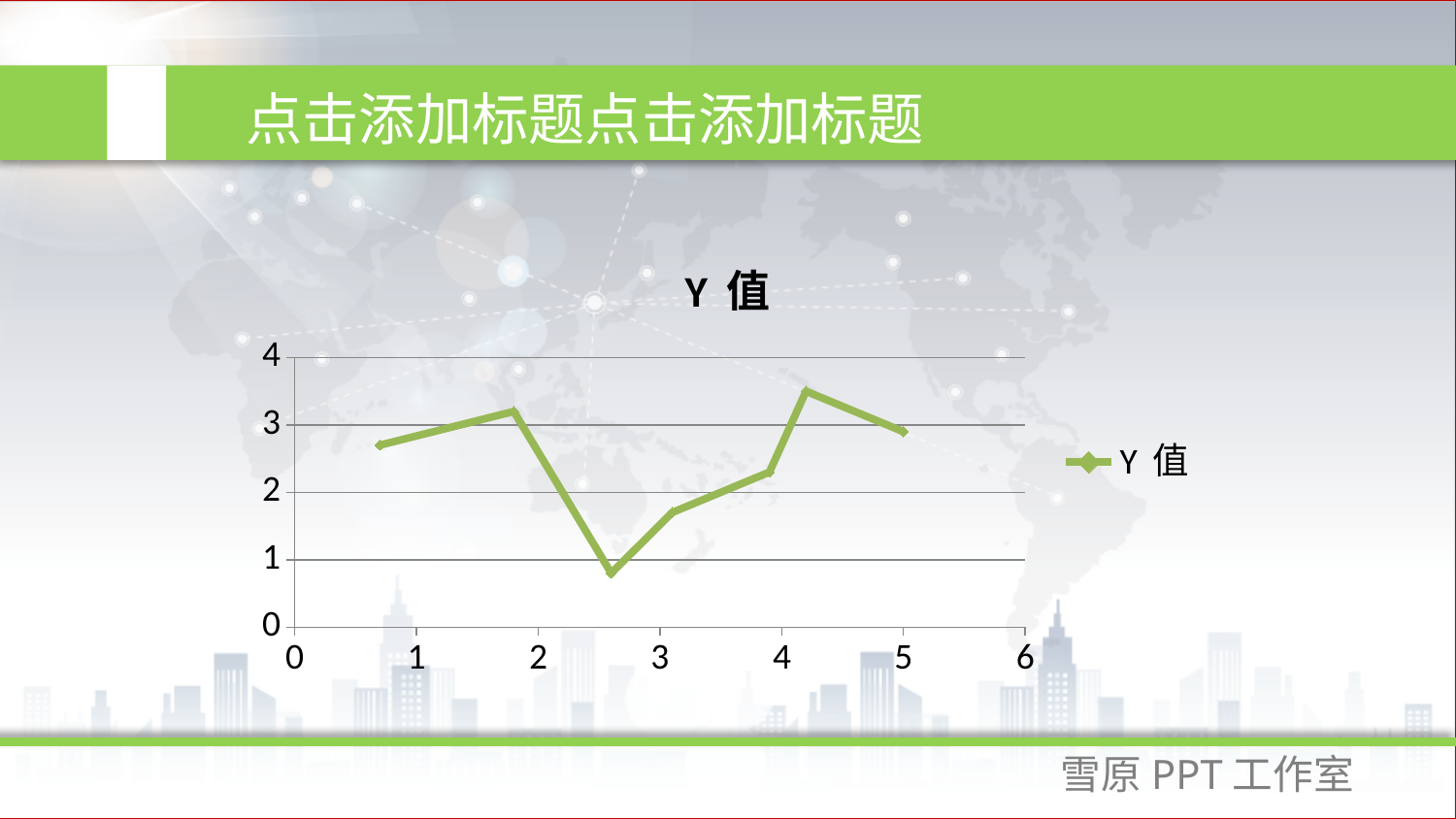
Is the value of the sixth point from the left greater or less than 3? greater Do the values rise or fall from the third point to the sixth point along the x axis? rise Which point has the lowest value: the third point from the left or the fifth point from the left? the third point from the left What is the name of the series shown in the legend? Y 值 Is the value of the third point from the left greater or less than 1? less What is the title of the chart? Y 值 Is the value of the fourth point from the left greater or less than 2? less What kind of chart is shown on the slide? line chart How many series does the legend list? 1 How many data points are plotted on the line? 7 Which is larger: the value of the second point from the left or the value of the fourth point from the left? the second point from the left